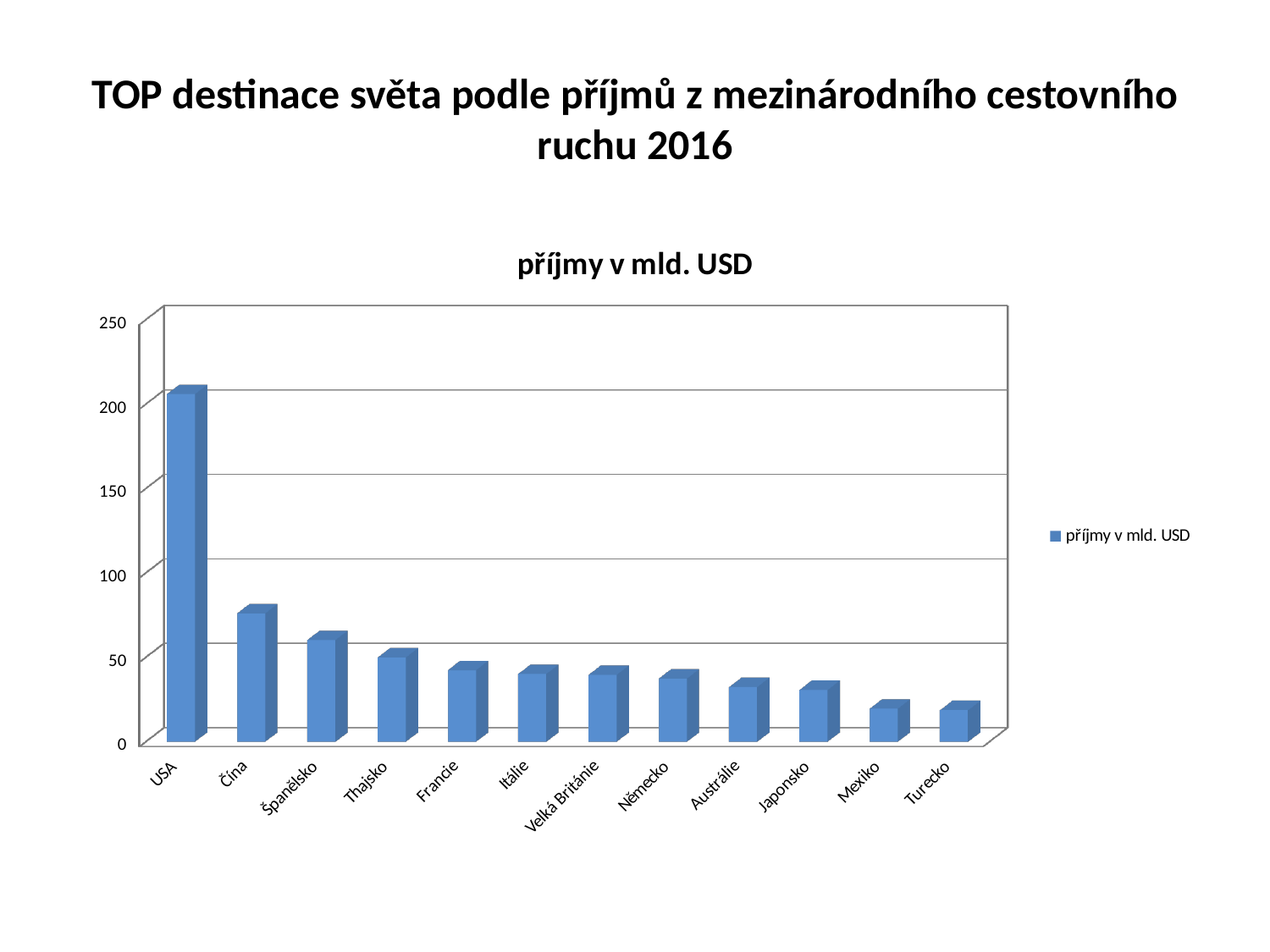
Is the value for USA greater or less than 150? greater How many series does the legend list? 1 Which country has the highest value in the chart? USA What is the legend entry of the chart? příjmy v mld. USD Do the values rise or fall from left to right along the x axis? fall Is the value for Mexiko greater or less than 50? less Which has a larger value, Čína or Španělsko? Čína What kind of chart is shown on the slide? bar chart How many countries are shown on the x axis of the chart? 12 Is the value for Španělsko greater or less than 50? greater What is the title of the chart? příjmy v mld. USD